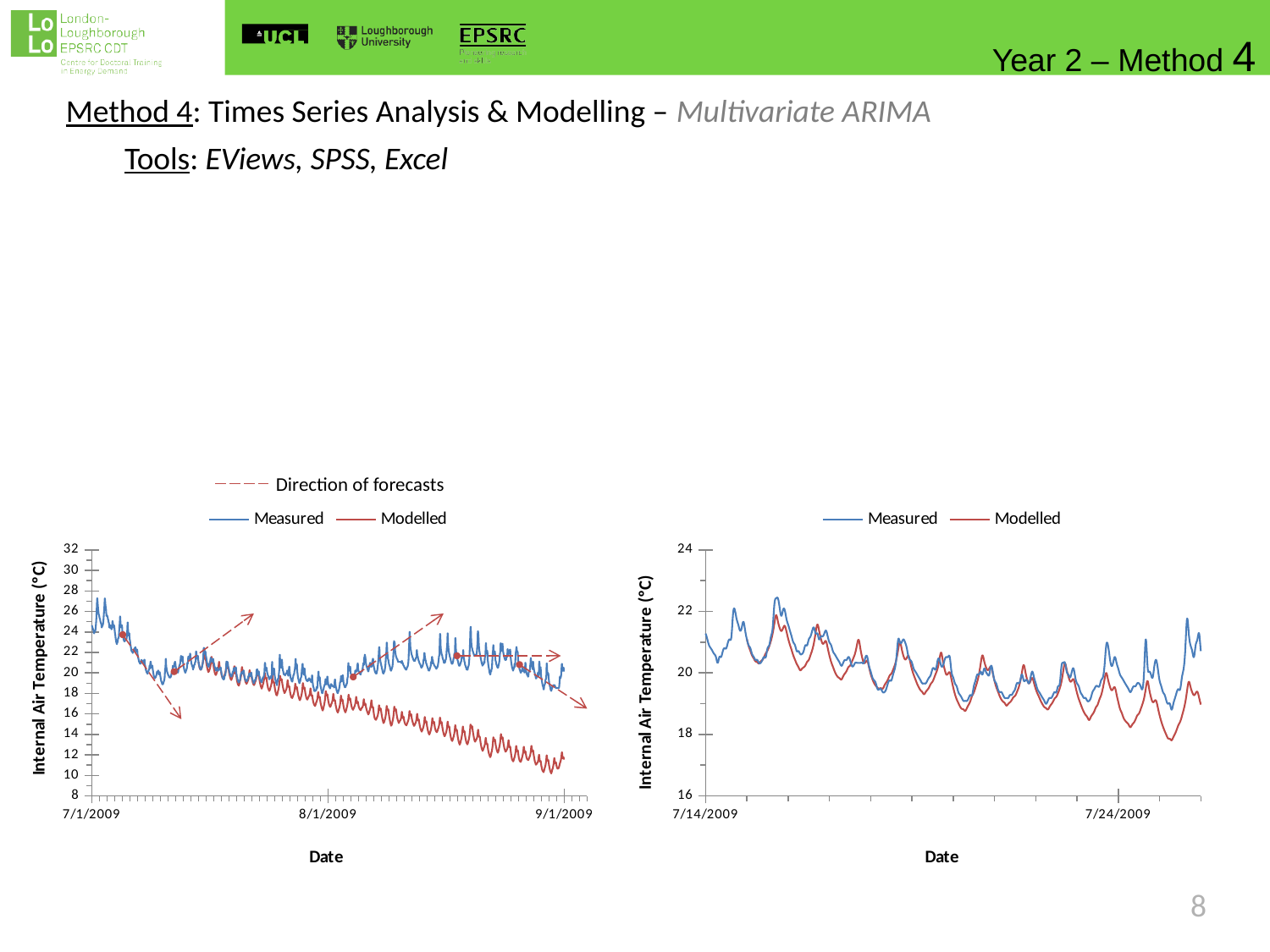
In the left chart, does the Modelled series rise or fall from 8/1/2009 to 9/1/2009? fall What is the x-axis title of the right chart? Date In the left chart, is the Modelled value at 9/1/2009 greater or less than 14? less How many series does the legend of the right chart list? 2 What is the y-axis title of the left chart? Internal Air Temperature (°C) How many entries does the legend of the left chart list? 3 What is the first date shown on the x axis of the right chart? 7/14/2009 In the right chart, is the Modelled value at 7/24/2009 greater or less than 20? less In the left chart, is the Measured value at 7/1/2009 greater or less than 22? greater In the left chart, which series is lower at 9/1/2009, Measured or Modelled? Modelled What kind of chart is the left chart on the slide? line chart